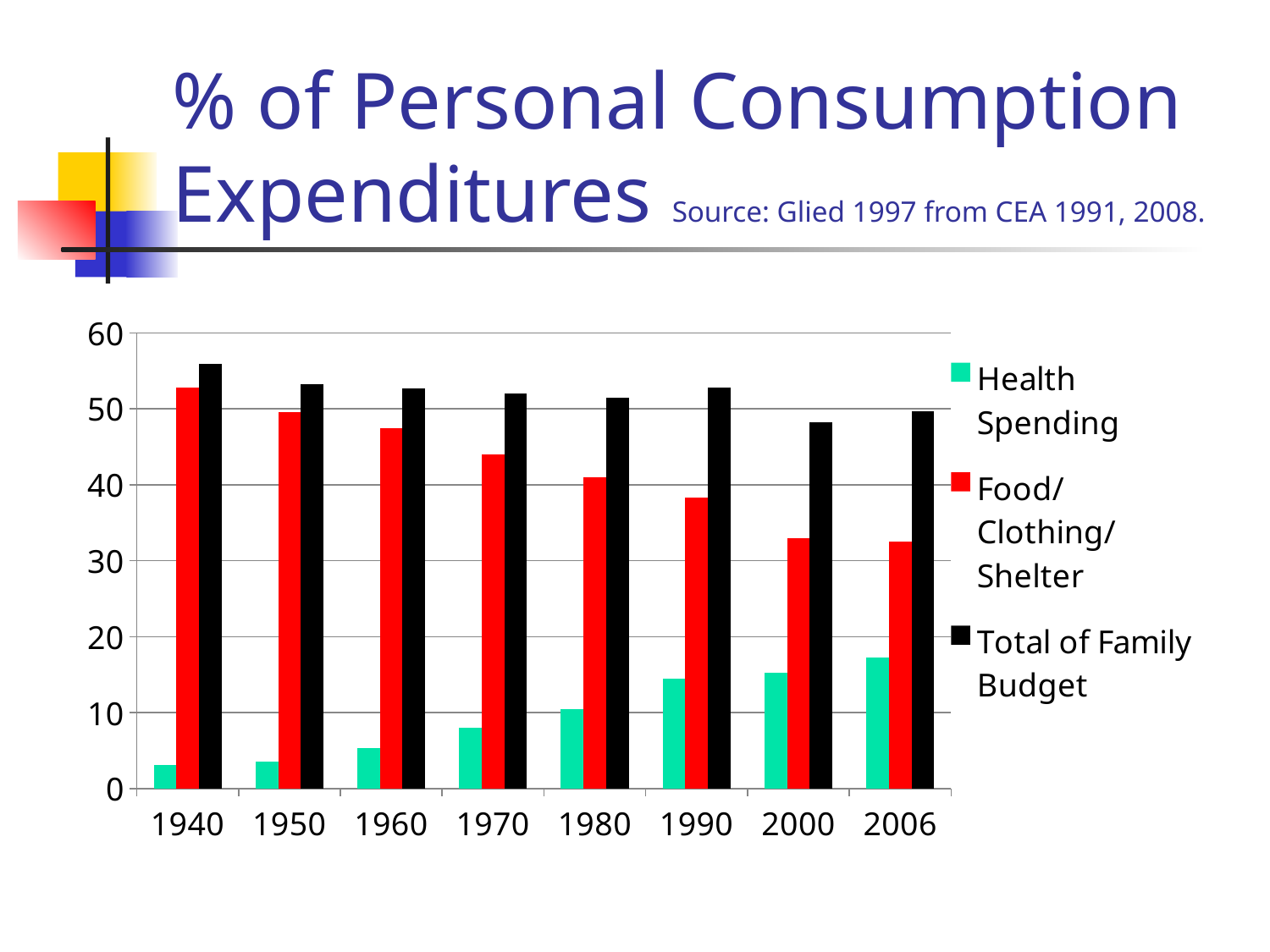
How many series does the legend list? 3 Is the value for Health Spending in 1990 greater or less than 10? greater Does Food/Clothing/Shelter rise or fall from 1940 to 2006? Fall How many years are shown along the x axis? 8 What colour represents Health Spending in the legend? Green In which year is Food/Clothing/Shelter highest? 1940 Which is larger: Total of Family Budget in 1940 or Total of Family Budget in 2000? 1940 Is the value for Food/Clothing/Shelter in 2000 greater or less than 40? less What kind of chart is shown on the slide? Bar chart In which year is Health Spending highest? 2006 In which year is Health Spending lowest? 1940 Does Health Spending rise or fall from 1940 to 2006? Rise